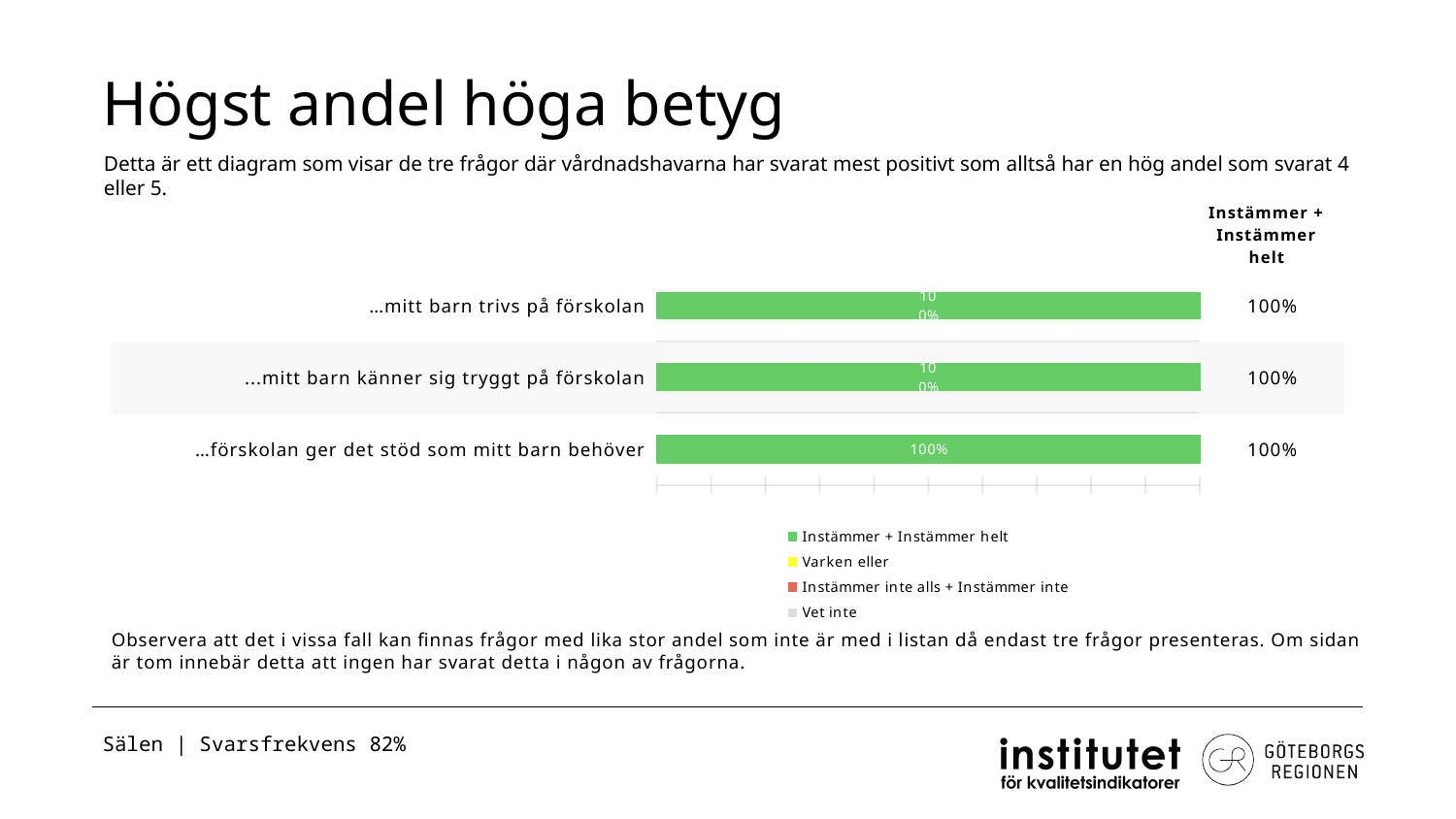
Which legend entry is shown in yellow? Varken eller What kind of chart is shown on the slide? Bar chart What is the difference between the "Instämmer + Instämmer helt" values for "…mitt barn trivs på förskolan" and "…förskolan ger det stöd som mitt barn behöver"? 0% What percentage is shown in the "Instämmer + Instämmer helt" column for "…mitt barn trivs på förskolan"? 100% What percentage is shown in the "Instämmer + Instämmer helt" column for "...mitt barn känner sig tryggt på förskolan"? 100% What is the title of the slide containing the chart? Högst andel höga betyg How many categories (questions) are plotted in the chart? 3 How many series does the legend list? 4 What is the total of the stacked bar for "…förskolan ger det stöd som mitt barn behöver"? 100% What is the value shown for "…förskolan ger det stöd som mitt barn behöver"? 100%